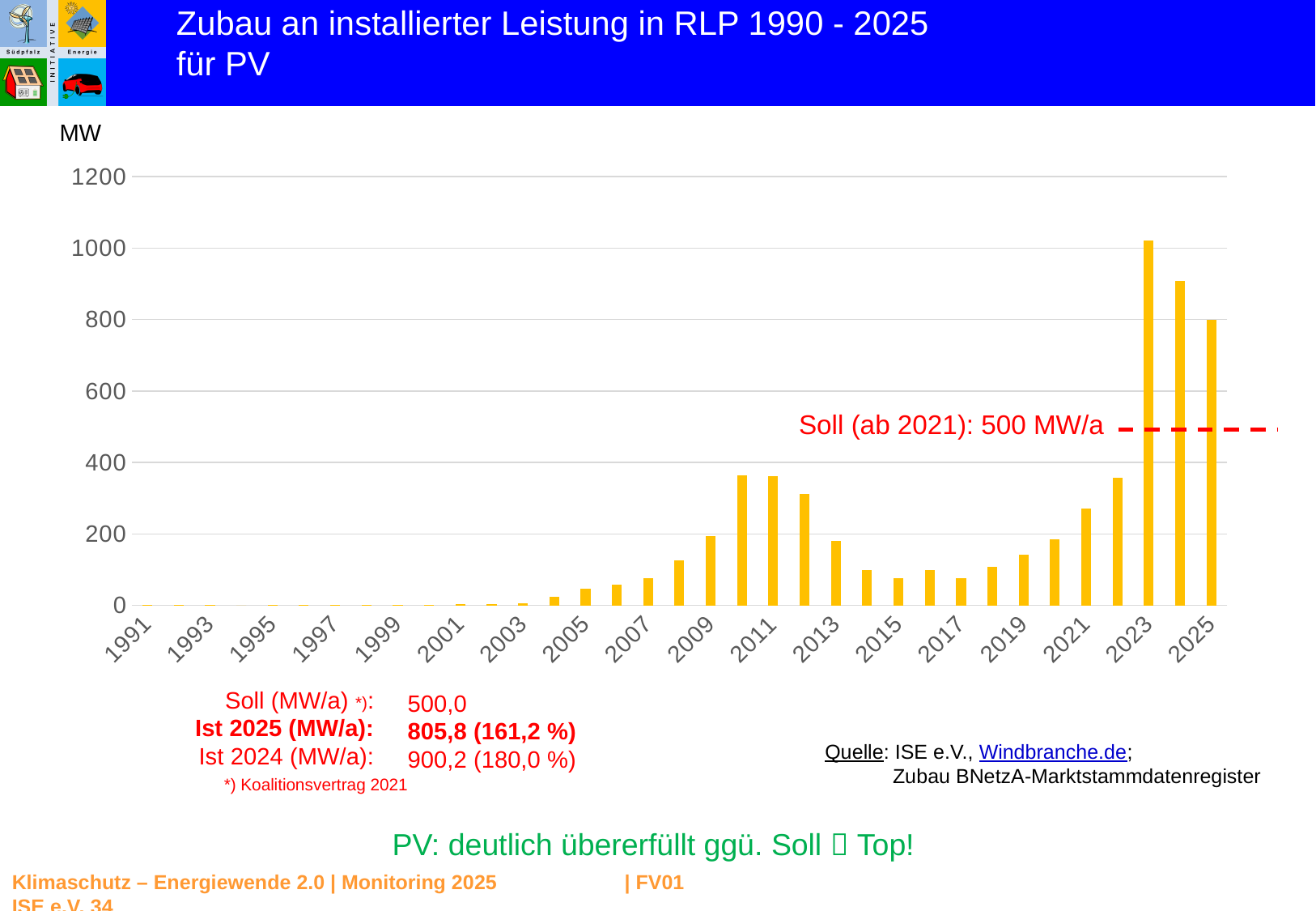
According to the slide, what is the Ist 2024 value in MW/a? 900,2 Which year has the larger value, 2023 or 2024? 2023 Which year has the larger value, 2008 or 2009? 2009 Is the value for 2021 greater or less than 400? less Is the value for 2012 greater or less than 400? less Is the value for 2022 greater or less than 200? greater According to the slide, what is the Ist 2025 value in MW/a? 805,8 Which year has the highest PV capacity addition in the chart? 2023 Do the values rise or fall from 2023 to 2025? fall What target value (Soll) does the dashed red line in the chart mark? 500 MW/a What kind of chart is shown on the slide? bar chart